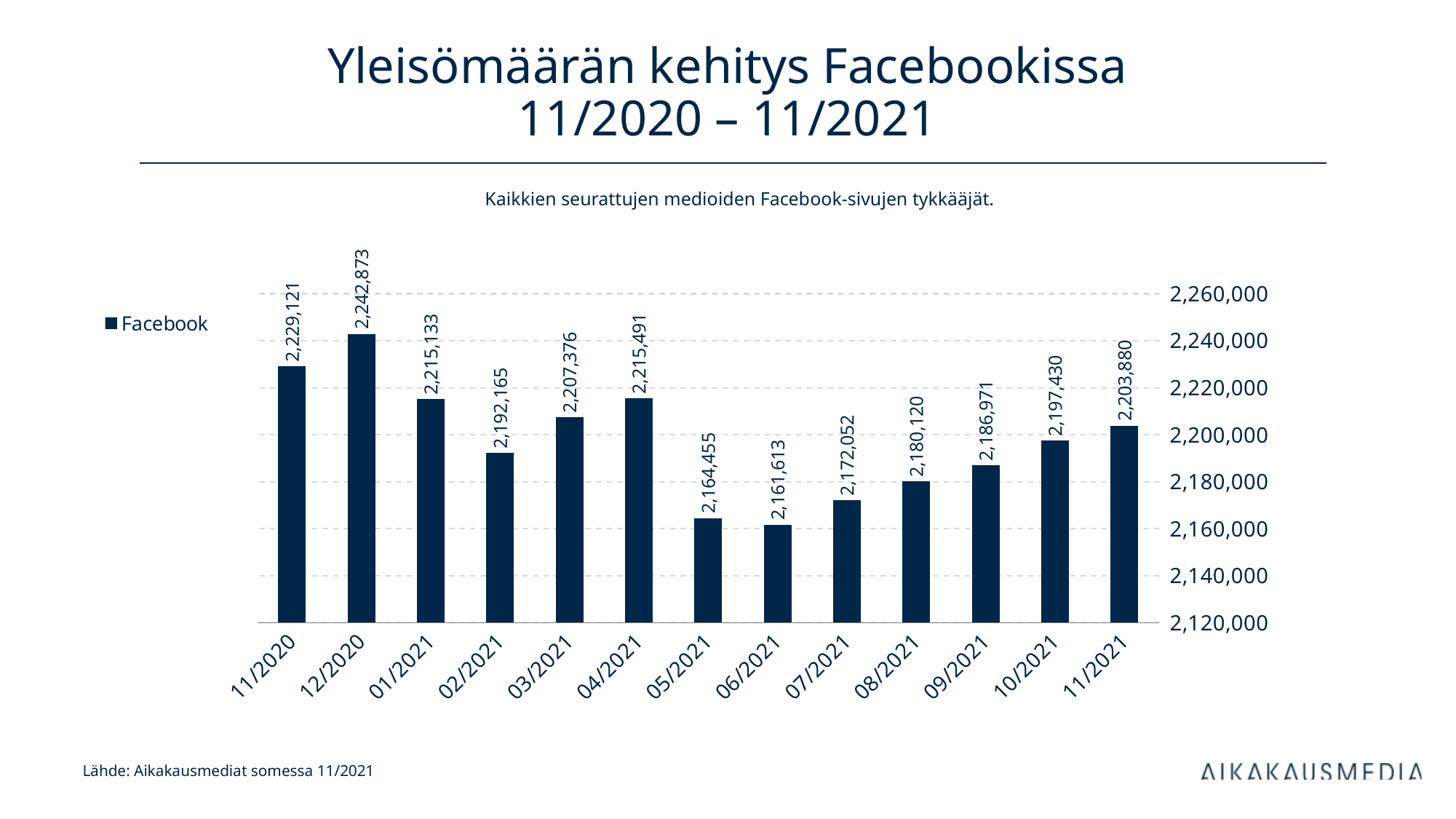
Which is larger, the value for 11/2020 or the value for 11/2021? 11/2020 How many series does the legend list? 1 What is the value for 06/2021? 2,161,613 Is the value for 05/2021 greater or less than 2,180,000? less Which month has the highest value? 12/2020 What is the value for 11/2021? 2,203,880 How many months are shown on the x axis? 13 What kind of chart is shown? bar chart Do the values rise or fall from 06/2021 to 11/2021? rise What is the value for 12/2020? 2,242,873 Which month has the lowest value? 06/2021 What is the difference between the values for 12/2020 and 06/2021? 81,260